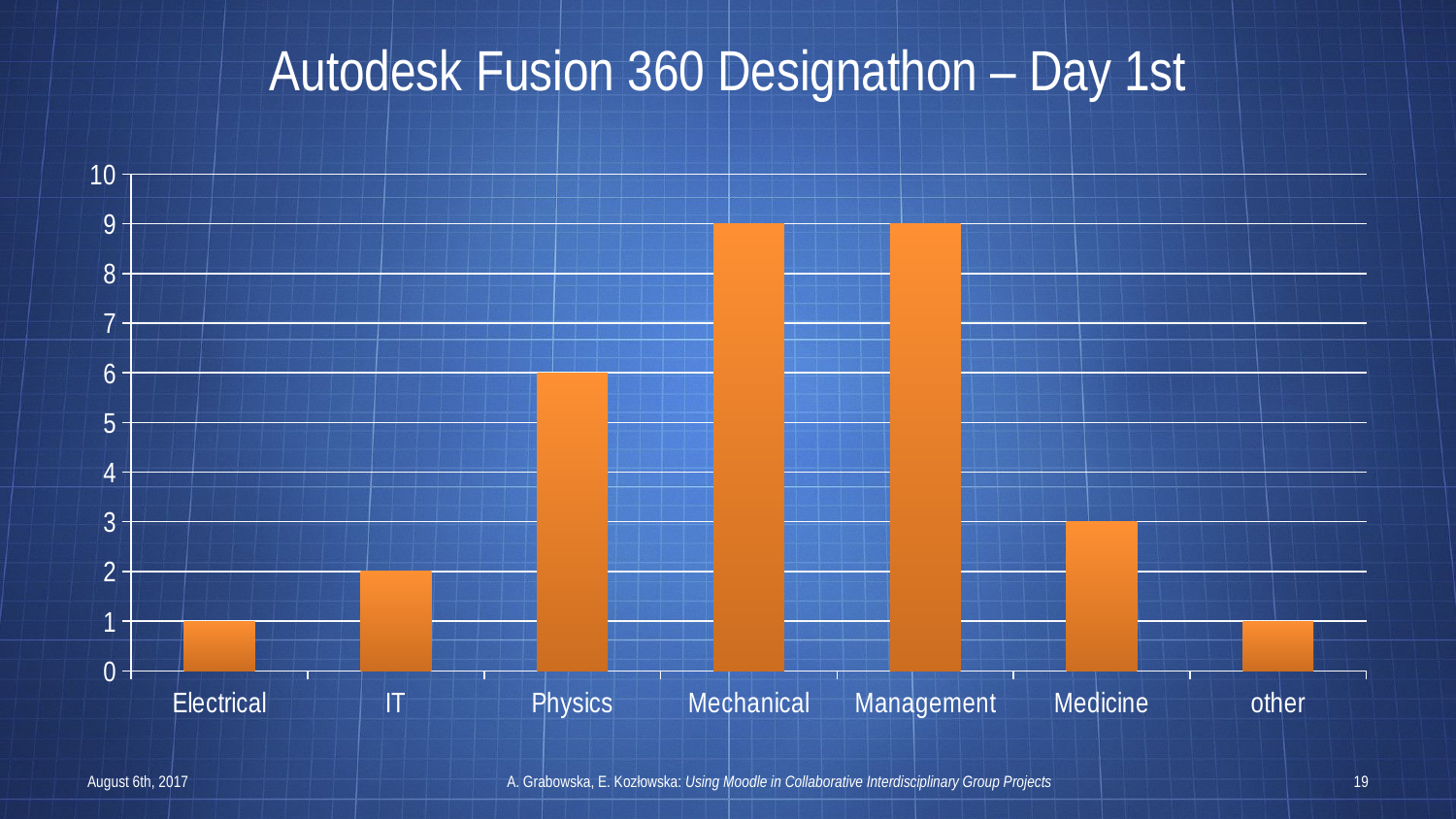
What is the value for Mechanical? 9 What is the title of the slide? Autodesk Fusion 360 Designathon – Day 1st What is the difference between the values for Physics and IT? 4 Which is larger, the value for Physics or the value for Medicine? Physics How many categories are shown on the x axis? 7 What is the value for Electrical? 1 What is the value for Medicine? 3 Is the value for Management greater or less than 5? greater What is the value for Physics? 6 What is the value for IT? 2 What kind of chart is shown on the slide? bar chart What is the difference between the values for Mechanical and Medicine? 6